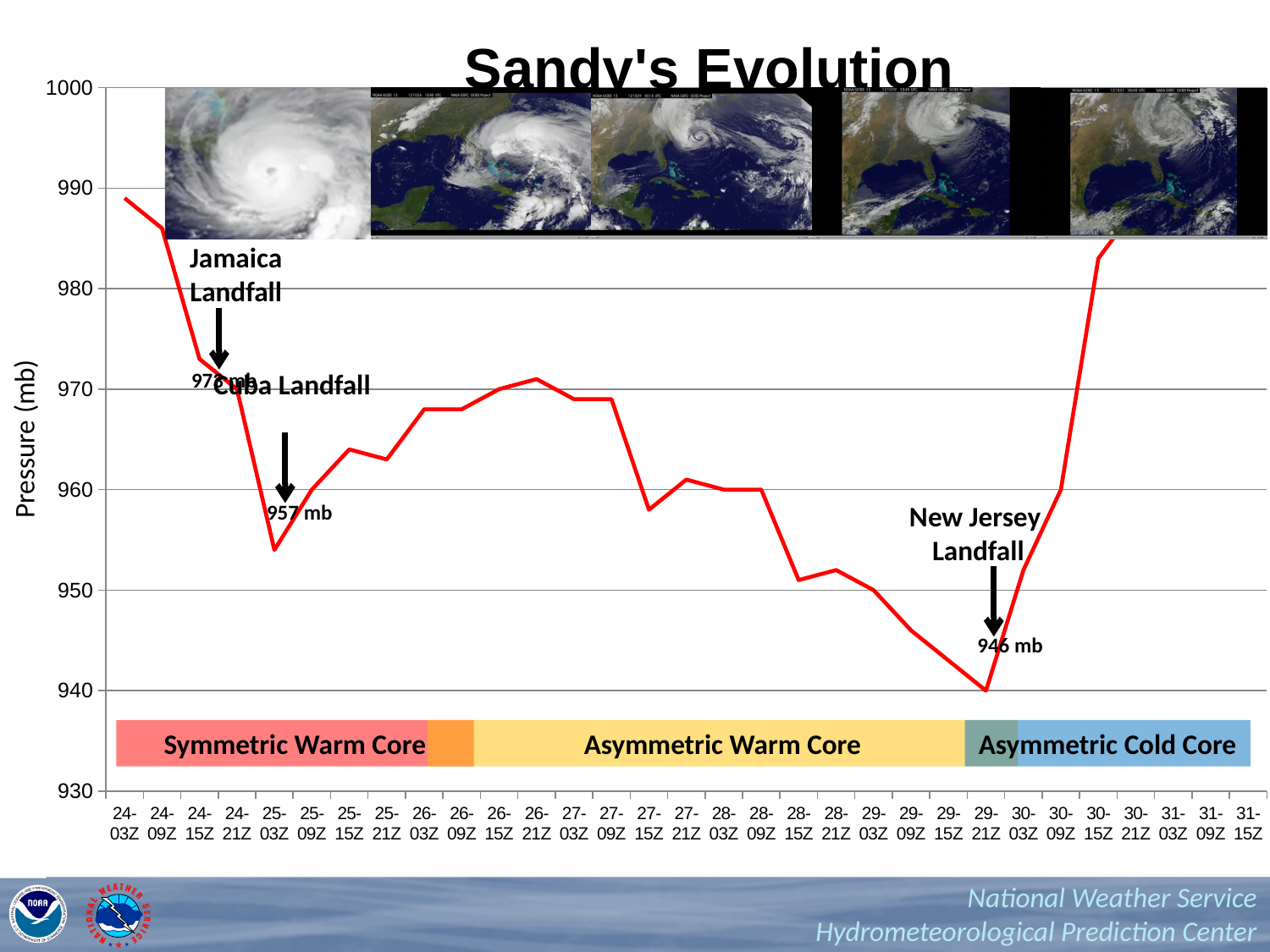
Is the pressure at 24-03Z greater or less than 980? greater What is the title of the chart? Sandy's Evolution Is the pressure at 29-21Z greater or less than 950? less What kind of chart is shown on the slide? line chart Is the pressure at 26-21Z greater or less than 960? greater At which time on the x axis does the pressure reach its lowest point? 29-21Z What pressure is annotated at the Cuba Landfall? 957 mb What is the difference between the annotated Cuba Landfall pressure and the New Jersey Landfall pressure? 11 mb What is the label of the vertical axis? Pressure (mb) Which annotated landfall pressure is higher, Cuba Landfall or New Jersey Landfall? Cuba Landfall Does the pressure rise or fall between 29-21Z and 31-15Z? rise What pressure is annotated at the New Jersey Landfall? 946 mb